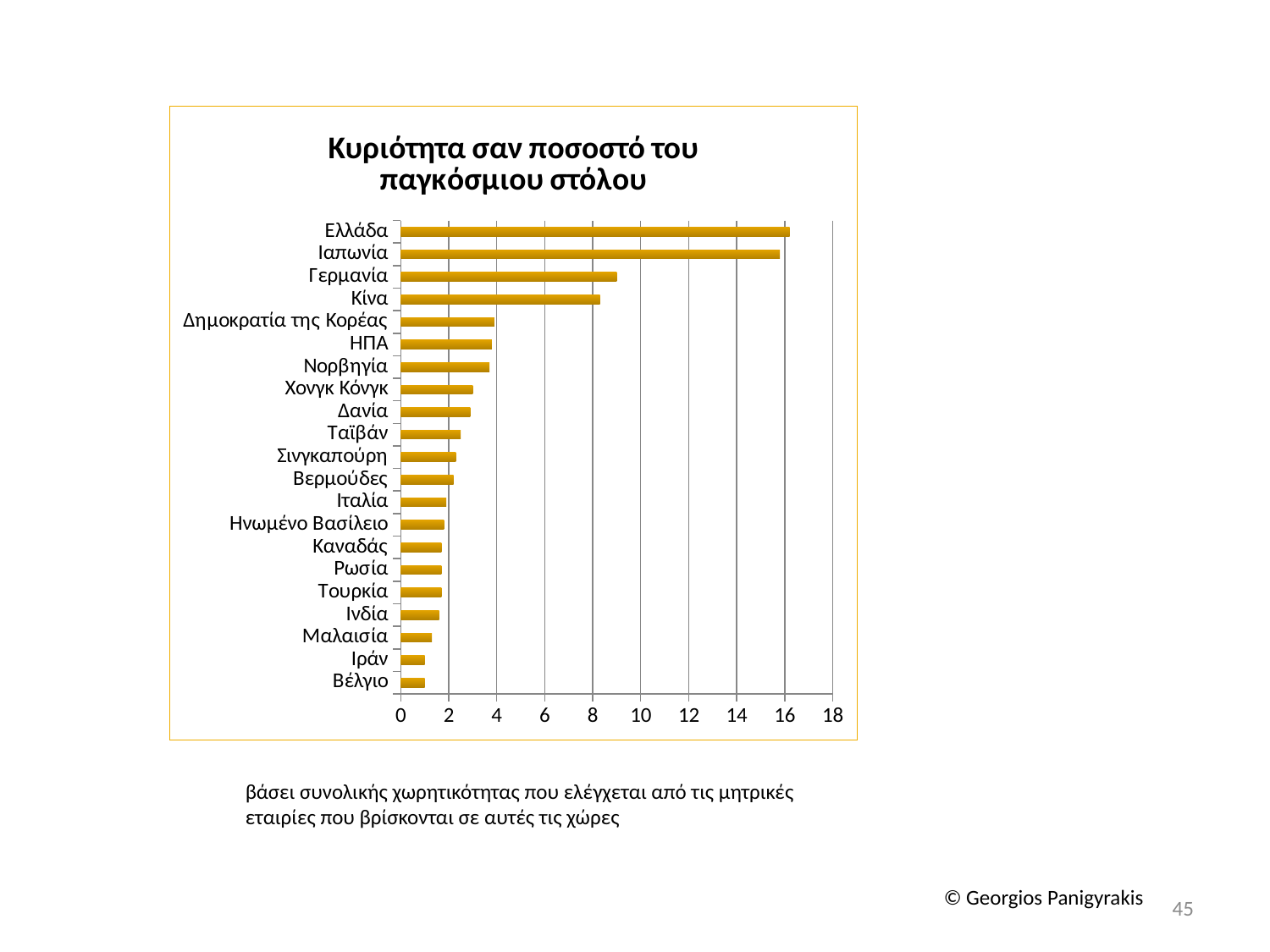
Which country has the highest value in the chart? Ελλάδα Is the value for Δημοκρατία της Κορέας greater or less than 6? less Is the value for Γερμανία greater or less than 8? greater How many countries are plotted in the chart? 21 Is the value for Βέλγιο greater or less than 2? less Which has a larger value, Χονγκ Κόνγκ or Ιταλία? Χονγκ Κόνγκ What is the title of the chart? Κυριότητα σαν ποσοστό του παγκόσμιου στόλου What kind of chart is shown on the slide? bar chart Which has a larger value, Γερμανία or Κίνα? Γερμανία Which has a larger value, Ιαπωνία or Νορβηγία? Ιαπωνία